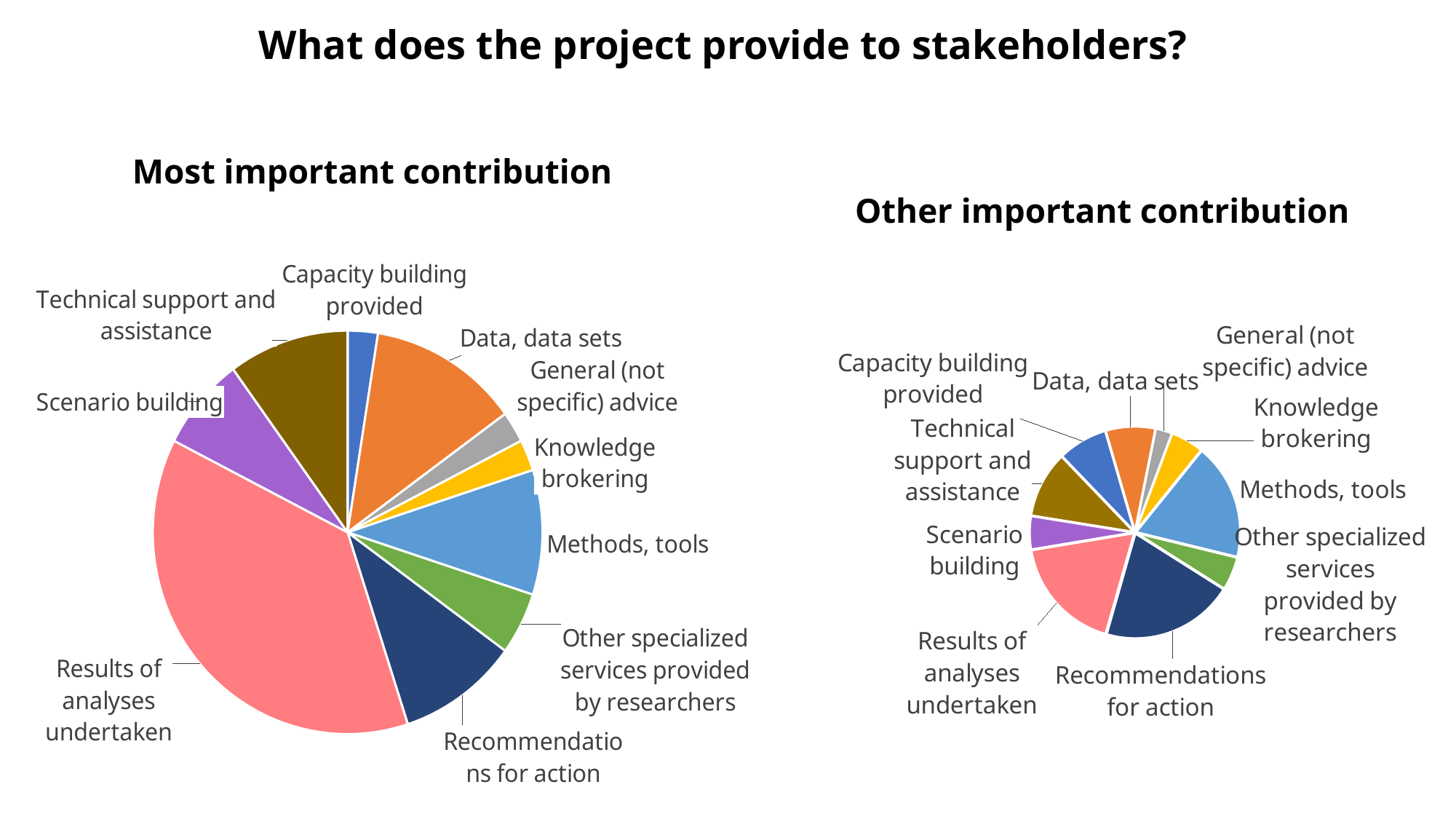
In the "Most important contribution" chart, which category has the largest slice? Results of analyses undertaken In the "Most important contribution" chart, which slice is larger: Data, data sets or Knowledge brokering? Data, data sets What type of chart is the "Other important contribution" chart? Pie chart In the "Most important contribution" chart, what colour is the Results of analyses undertaken slice? Pink In the "Other important contribution" chart, which slice is larger: Methods, tools or Scenario building? Methods, tools In the "Other important contribution" chart, which category has the smallest slice? General (not specific) advice In the "Other important contribution" chart, which slice is larger: Technical support and assistance or Knowledge brokering? Technical support and assistance How many slices does the "Other important contribution" pie chart have? 10 What is the title of the slide containing the two pie charts? What does the project provide to stakeholders? How many slices does the "Most important contribution" pie chart have? 10 What type of chart is the "Most important contribution" chart? Pie chart